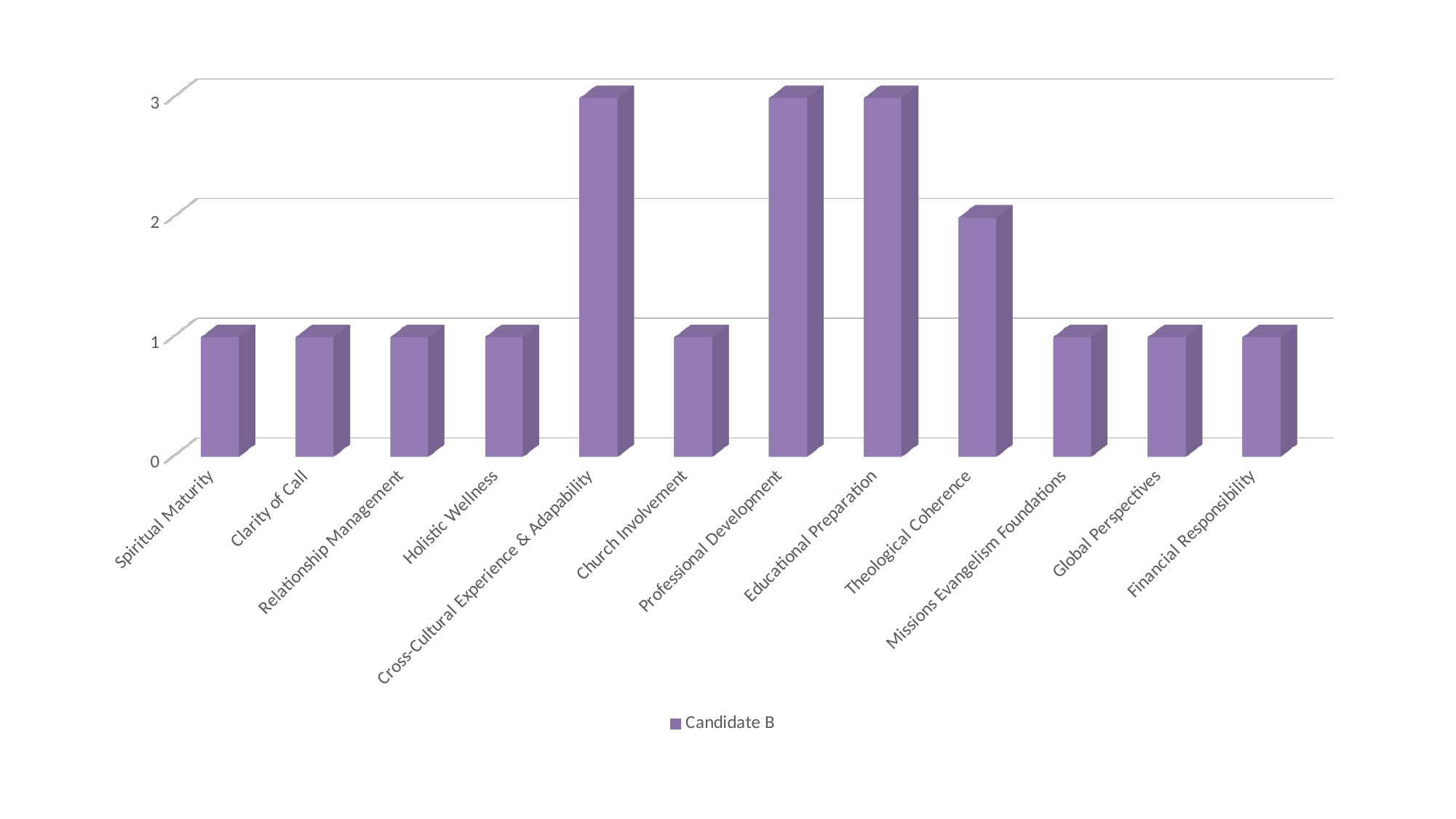
How many categories are shown on the x axis of the chart? 12 What series name is shown in the legend? Candidate B What type of chart is shown on the slide? bar chart What is the difference between the value for Educational Preparation and the value for Financial Responsibility? 2 What is the value for Professional Development? 3 What is the value for Cross-Cultural Experience & Adapability? 3 How many series does the legend list? 1 What is the value for Theological Coherence? 2 What is the difference between the value for Professional Development and the value for Theological Coherence? 1 What is the value for Church Involvement? 1 Which is larger, the value for Educational Preparation or the value for Theological Coherence? Educational Preparation Which is larger, the value for Theological Coherence or the value for Global Perspectives? Theological Coherence